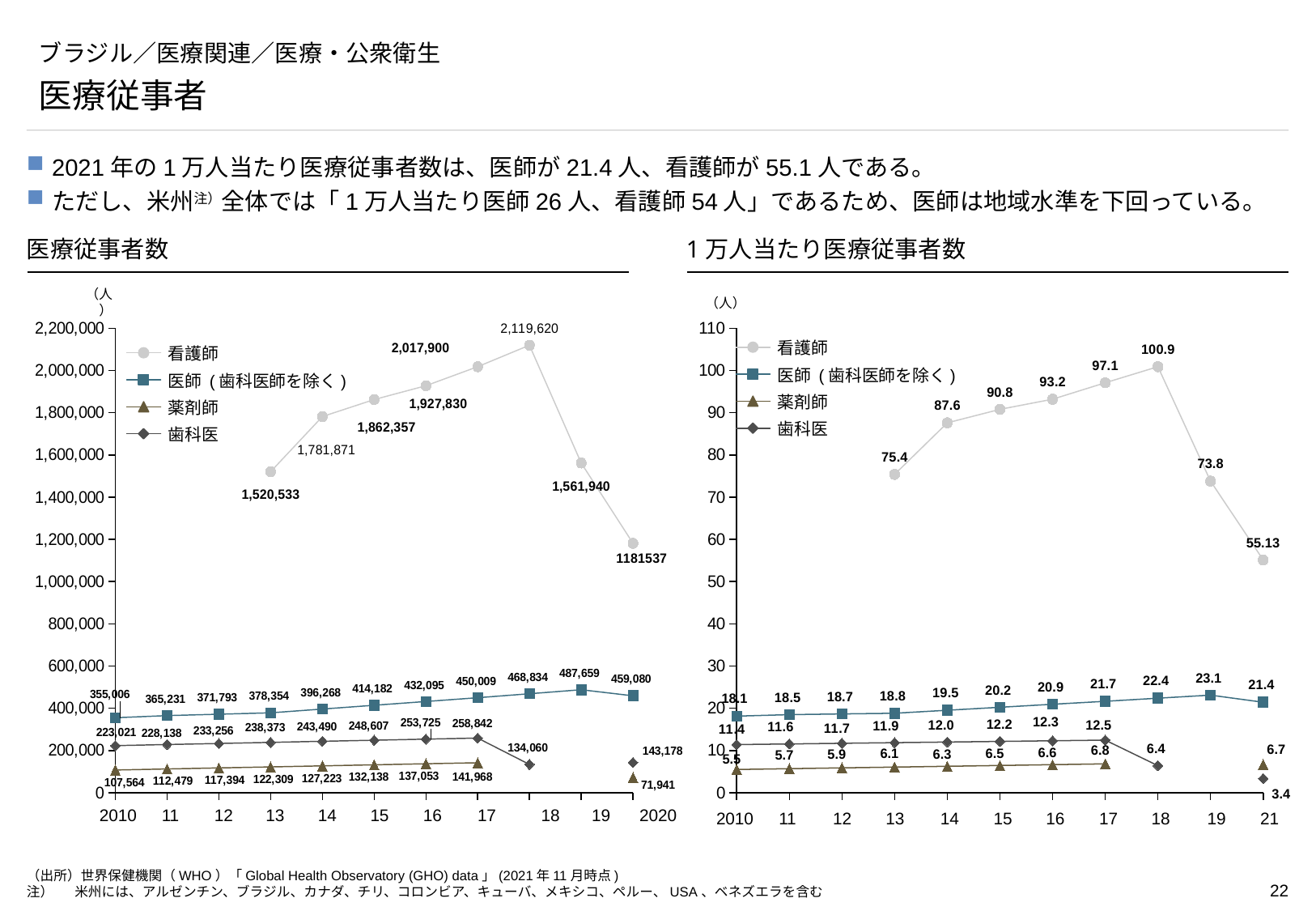
In the 医療従事者数 chart on the left, what is the value for 医師（歯科医師を除く） in 2019? 487,659 In the 医療従事者数 chart on the left, how many series does the legend list? 4 In the 医療従事者数 chart on the left, which series has the highest value in 2017? 看護師 In the 医療従事者数 chart on the left, what is the value for 看護師 in 2018? 2,119,620 In the 1万人当たり医療従事者数 chart on the right, in which year does 看護師 reach its highest value? 2018 In the 1万人当たり医療従事者数 chart on the right, which is larger in 2021: 薬剤師 or 歯科医? 薬剤師 What kind of chart is the 1万人当たり医療従事者数 chart on the right? line chart In the 医療従事者数 chart on the left, what is the value for 薬剤師 in 2010? 107,564 In the 医療従事者数 chart on the left, what is the difference between the 医師（歯科医師を除く） values for 2019 and 2020? 28,579 In the 1万人当たり医療従事者数 chart on the right, what is the value for 看護師 in 2021? 55.13 In the 1万人当たり医療従事者数 chart on the right, what is the difference between the 医師（歯科医師を除く） values for 2019 and 2021? 1.7 In the 1万人当たり医療従事者数 chart on the right, does the 医師（歯科医師を除く） series rise or fall from 2010 to 2019? rise